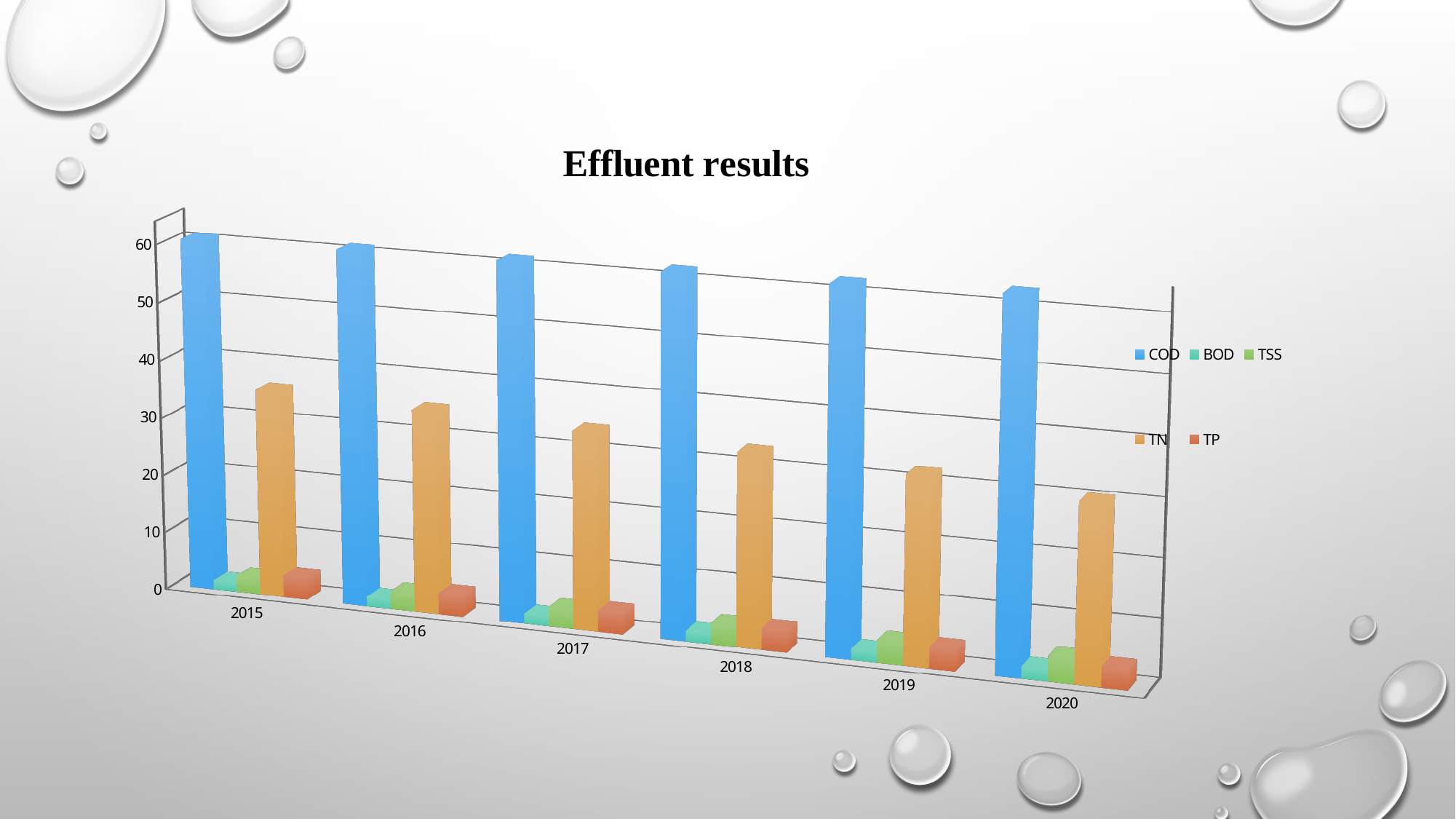
Which series has the highest value in 2015? COD Which series has the highest value in 2020? COD In 2018, which is larger, COD or TN? COD How many years are shown on the x axis? 6 What is the title of the chart? Effluent results Is the value for COD in 2015 greater or less than 40? greater In 2016, which is larger, TN or TP? TN What kind of chart is shown on the slide? bar chart How many series does the legend list? 5 Is the value for TP in 2019 greater or less than 10? less Which series is shown in blue in the legend? COD Do the TN values rise or fall from 2015 to 2020? fall